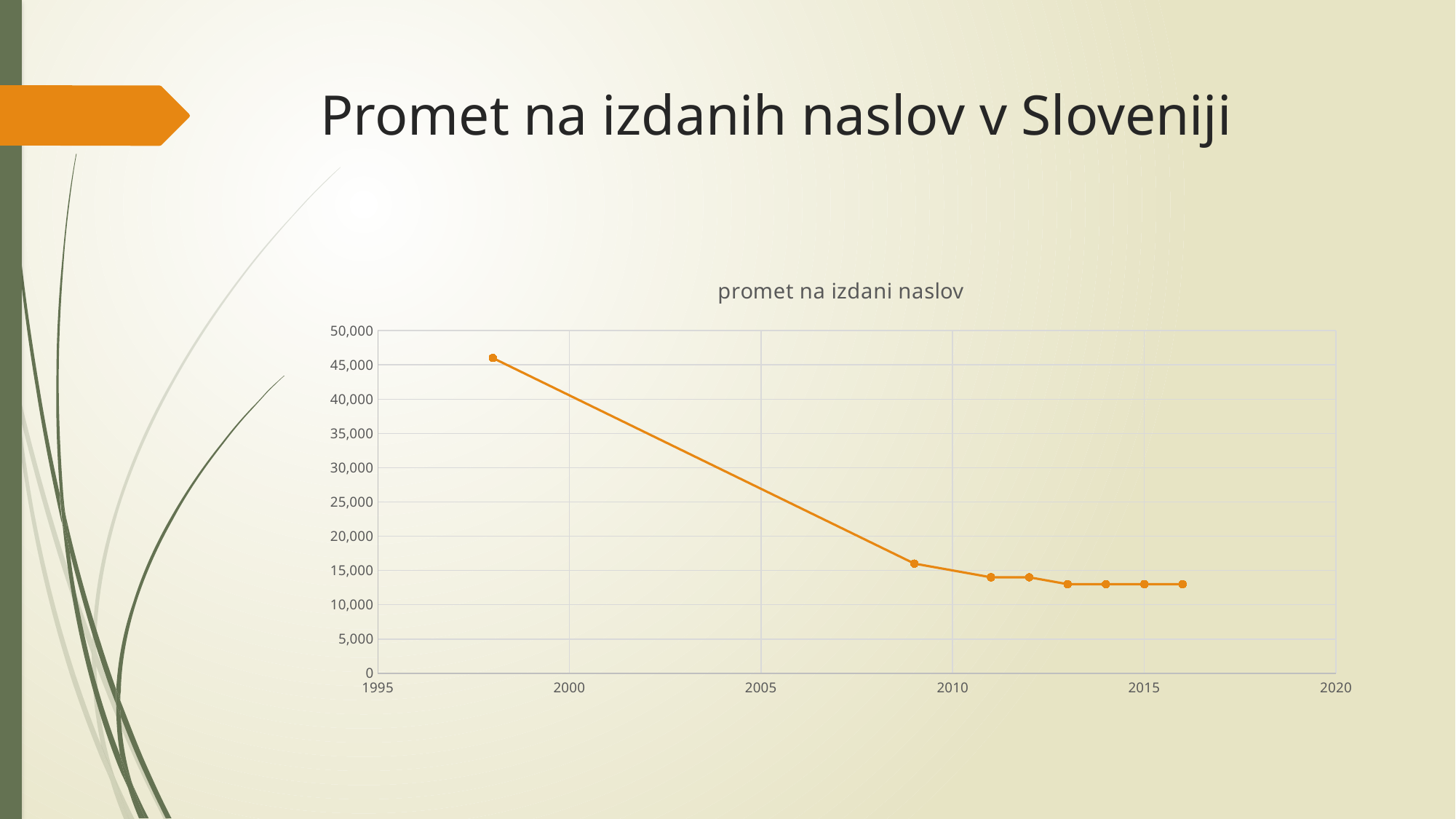
Which year has the larger value, 2009 or 2016? 2009 Do the values generally rise or fall from 1998 to 2016? fall Is the value for 1998 greater or less than 40,000? greater In which year is the plotted value highest? 1998 Is the value for 2016 greater or less than 15,000? less Is the value for 2013 greater or less than 10,000? greater Which year has the larger value, 1998 or 2009? 1998 What is the title of the chart? promet na izdani naslov How many data points are plotted on the line? 8 What kind of chart is shown on the slide? line chart What colour is the plotted line? orange